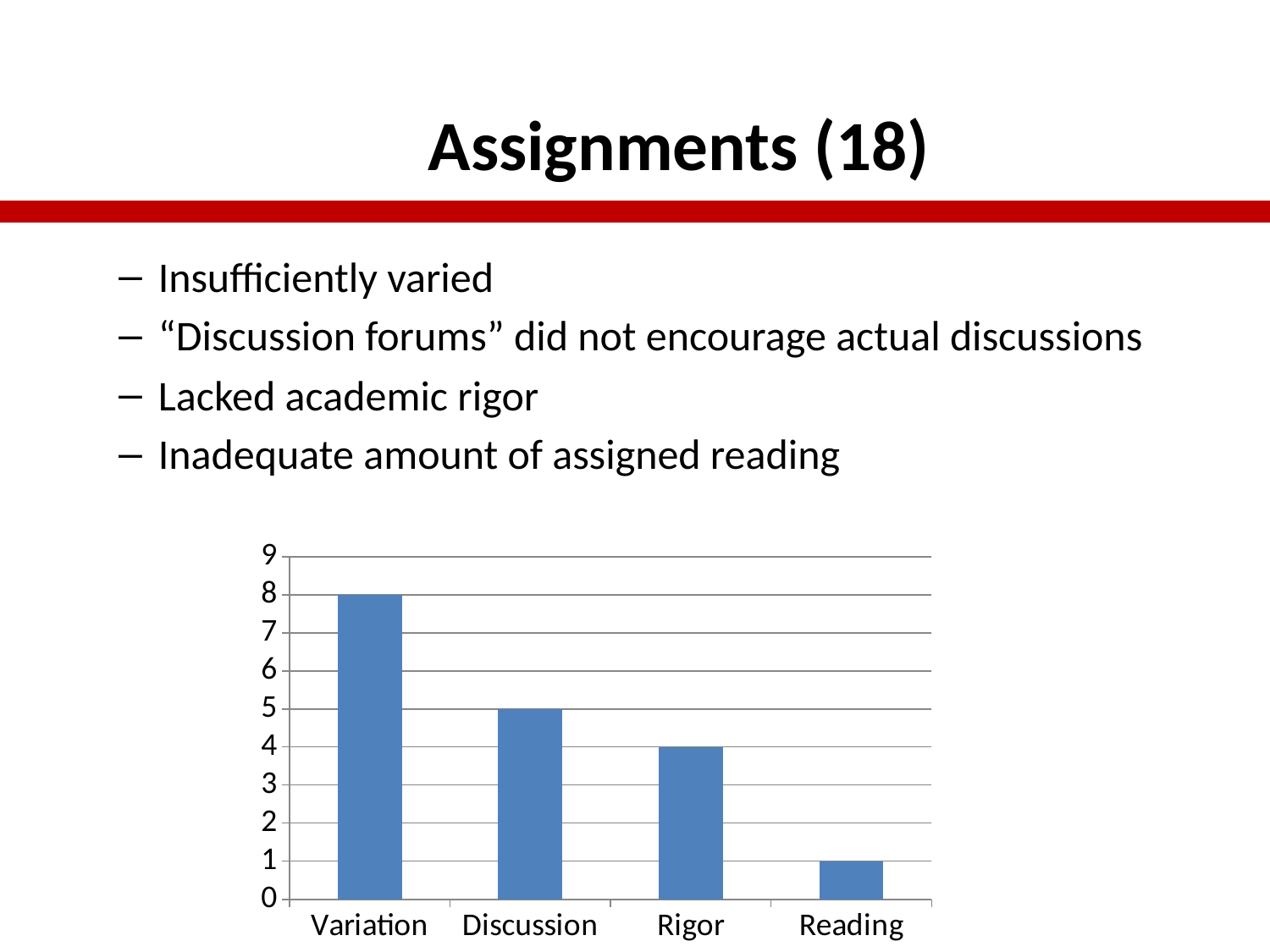
What is the highest value shown on the y axis of the chart? 9 Which is larger, the value for Rigor or the value for Reading? Rigor Which category has the lowest value? Reading What is the difference between the values for Variation and Discussion? 3 What is the value for Variation? 8 Which category has the highest value? Variation What is the value for Reading? 1 What is the value for Rigor? 4 What kind of chart is shown on the slide? bar chart What is the value for Discussion? 5 Do the values rise or fall from left to right along the x axis? fall How many categories are shown on the x axis of the chart? 4